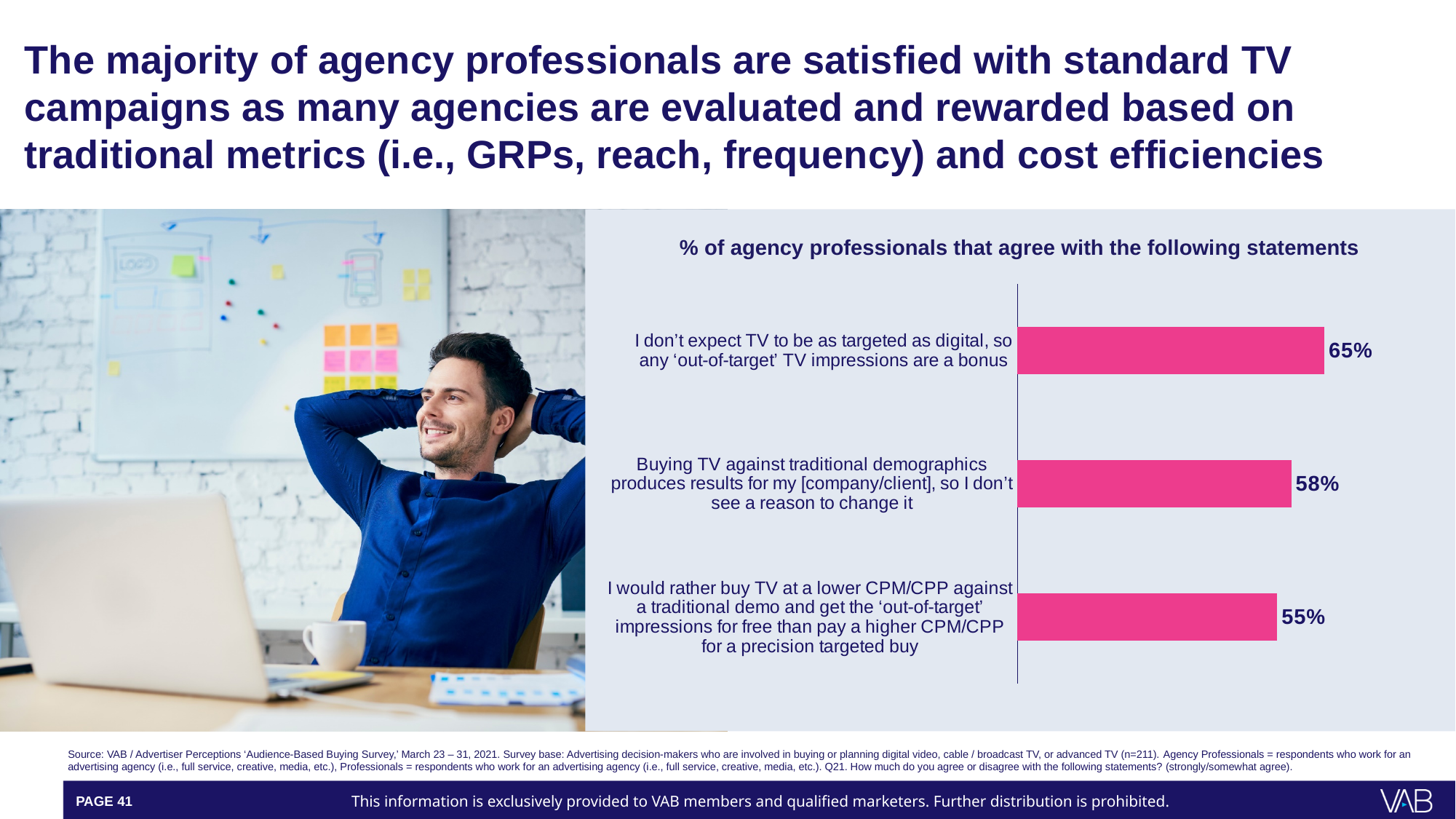
How many statements are shown in the chart? 3 What percentage of agency professionals agree that buying TV against traditional demographics produces results so they don't see a reason to change it? 58% Which has a higher agreement rate: the 'traditional demographics produces results' statement or the 'lower CPM/CPP' statement? The 'traditional demographics produces results' statement (58%) What colour are the bars in the chart? Pink What type of chart is shown on the slide? Bar chart How many percentage points higher is agreement with the 'out-of-target impressions are a bonus' statement than with the 'traditional demographics produces results' statement? 7 percentage points Which statement has the highest share of agency professionals agreeing? I don't expect TV to be as targeted as digital, so any 'out-of-target' TV impressions are a bonus What is the difference in percentage points between the highest and lowest bars in the chart? 10 percentage points Which statement has the lowest share of agency professionals agreeing? I would rather buy TV at a lower CPM/CPP against a traditional demo and get the 'out-of-target' impressions for free than pay a higher CPM/CPP for a precision targeted buy What percentage of agency professionals agree with the statement "I don't expect TV to be as targeted as digital, so any 'out-of-target' TV impressions are a bonus"? 65% What percentage of agency professionals agree they would rather buy TV at a lower CPM/CPP against a traditional demo than pay a higher CPM/CPP for a precision targeted buy? 55% What is the title of the chart? % of agency professionals that agree with the following statements